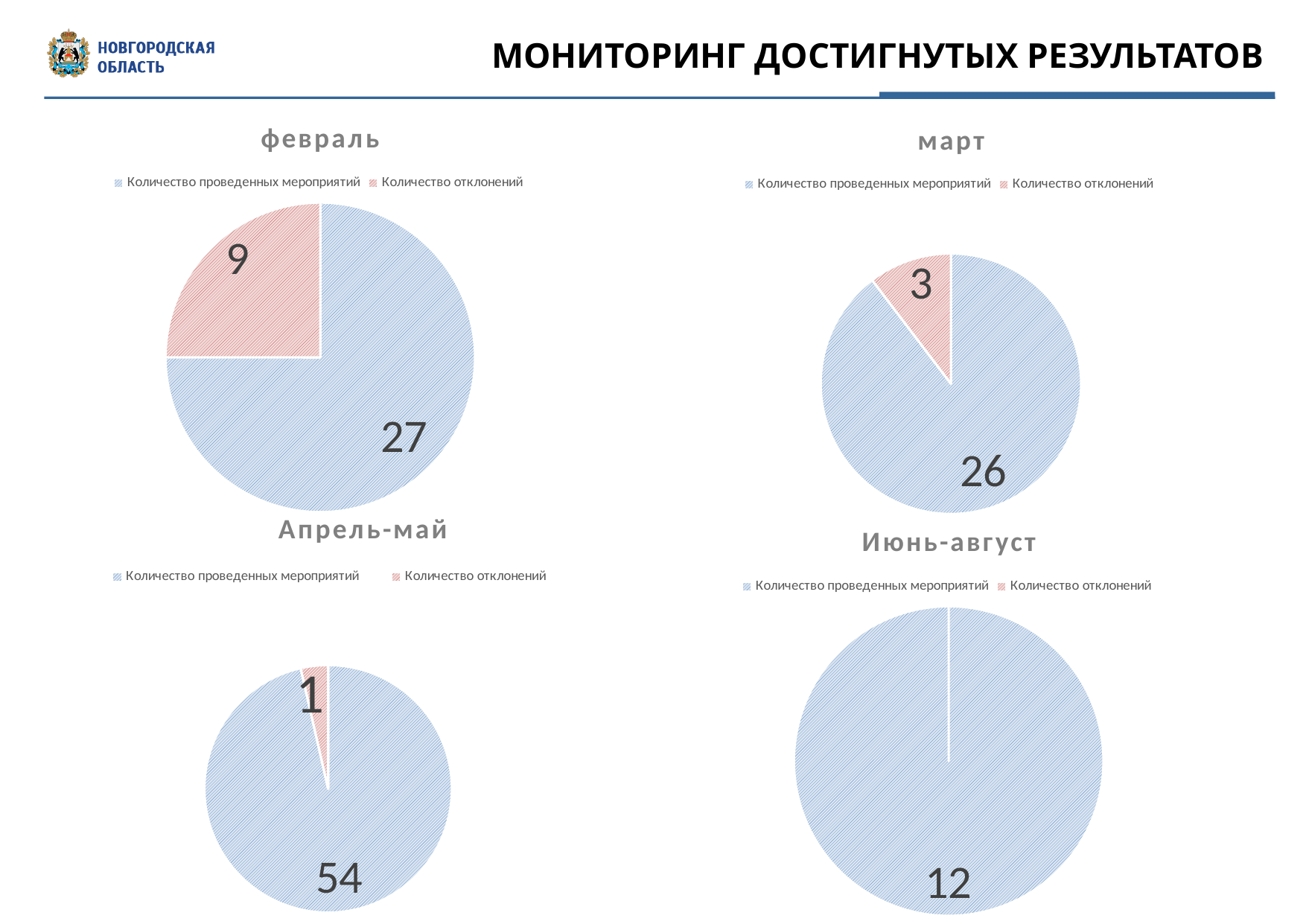
In the 'февраль' chart, what is the value for 'Количество отклонений'? 9 How many pie charts are shown on the slide? 4 How many series does the legend of the 'Июнь-август' chart list? 2 In the 'Апрель-май' chart, what is the value for 'Количество проведенных мероприятий'? 54 In the 'Июнь-август' chart, what is the value for 'Количество проведенных мероприятий'? 12 In the 'февраль' chart, what is the value for 'Количество проведенных мероприятий'? 27 In the 'март' chart, what is the value for 'Количество отклонений'? 3 In the 'февраль' chart, what is the difference between 'Количество проведенных мероприятий' and 'Количество отклонений'? 18 In the 'Апрель-май' chart, which slice is larger, 'Количество проведенных мероприятий' or 'Количество отклонений'? Количество проведенных мероприятий In the 'март' chart, what is the total of the two slices? 29 What kind of chart is the 'март' chart? Pie chart In the 'февраль' chart, what share of the pie does 'Количество отклонений' represent? 25%